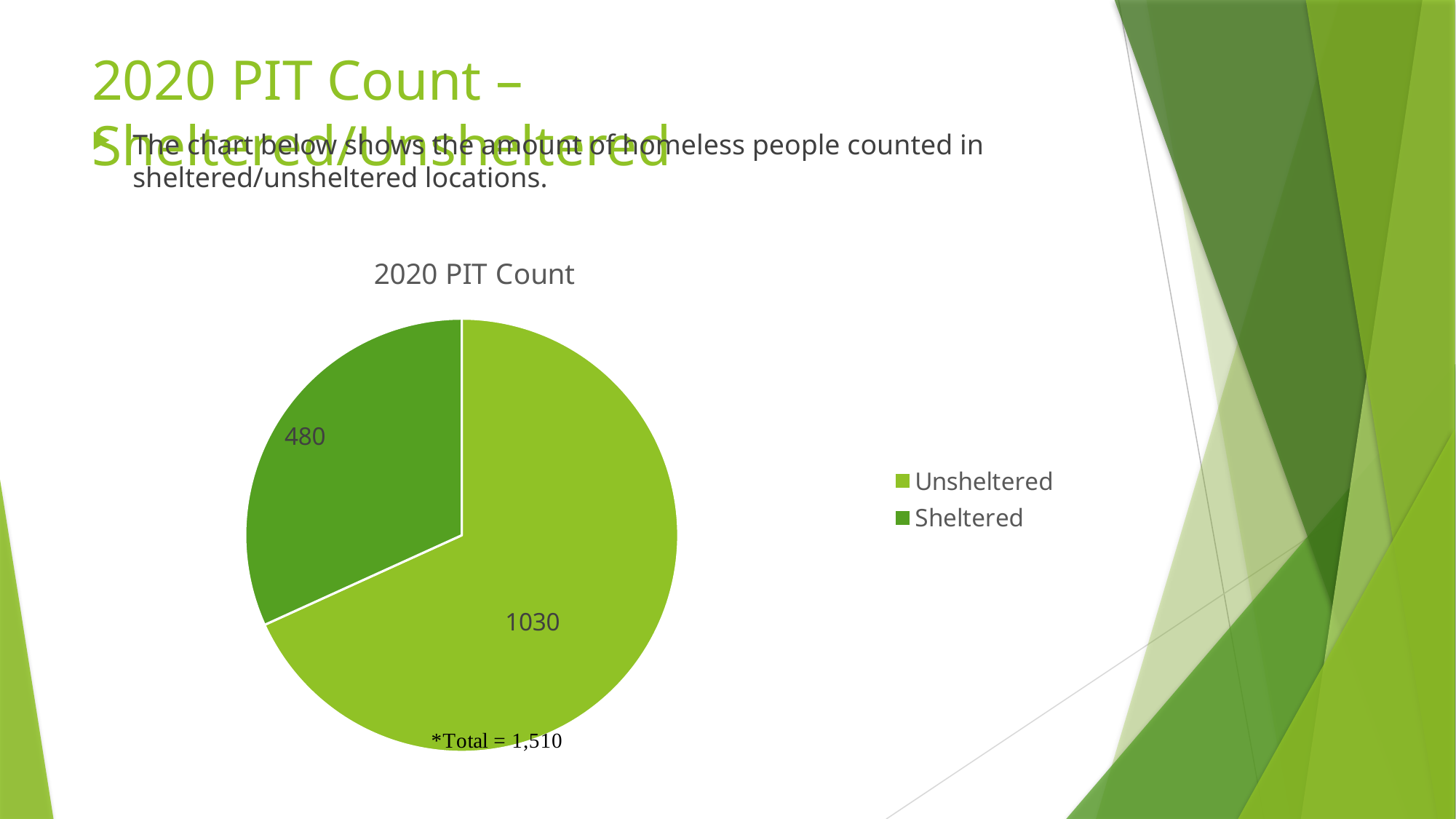
Which legend entry is shown in the darker green colour? Sheltered How many slices does the pie chart have? 2 Which category has the largest slice in the pie chart? Unsheltered Which is larger, the Sheltered value or the Unsheltered value? Unsheltered What total is printed below the pie chart? 1,510 What is the difference between the Unsheltered and Sheltered values? 550 What type of chart is shown on the slide? pie chart What is the value for Unsheltered in the 2020 PIT Count pie chart? 1030 Which category has the smallest slice in the pie chart? Sheltered What is the title of the chart? 2020 PIT Count What is the value for Sheltered in the 2020 PIT Count pie chart? 480 How many entries does the legend list? 2